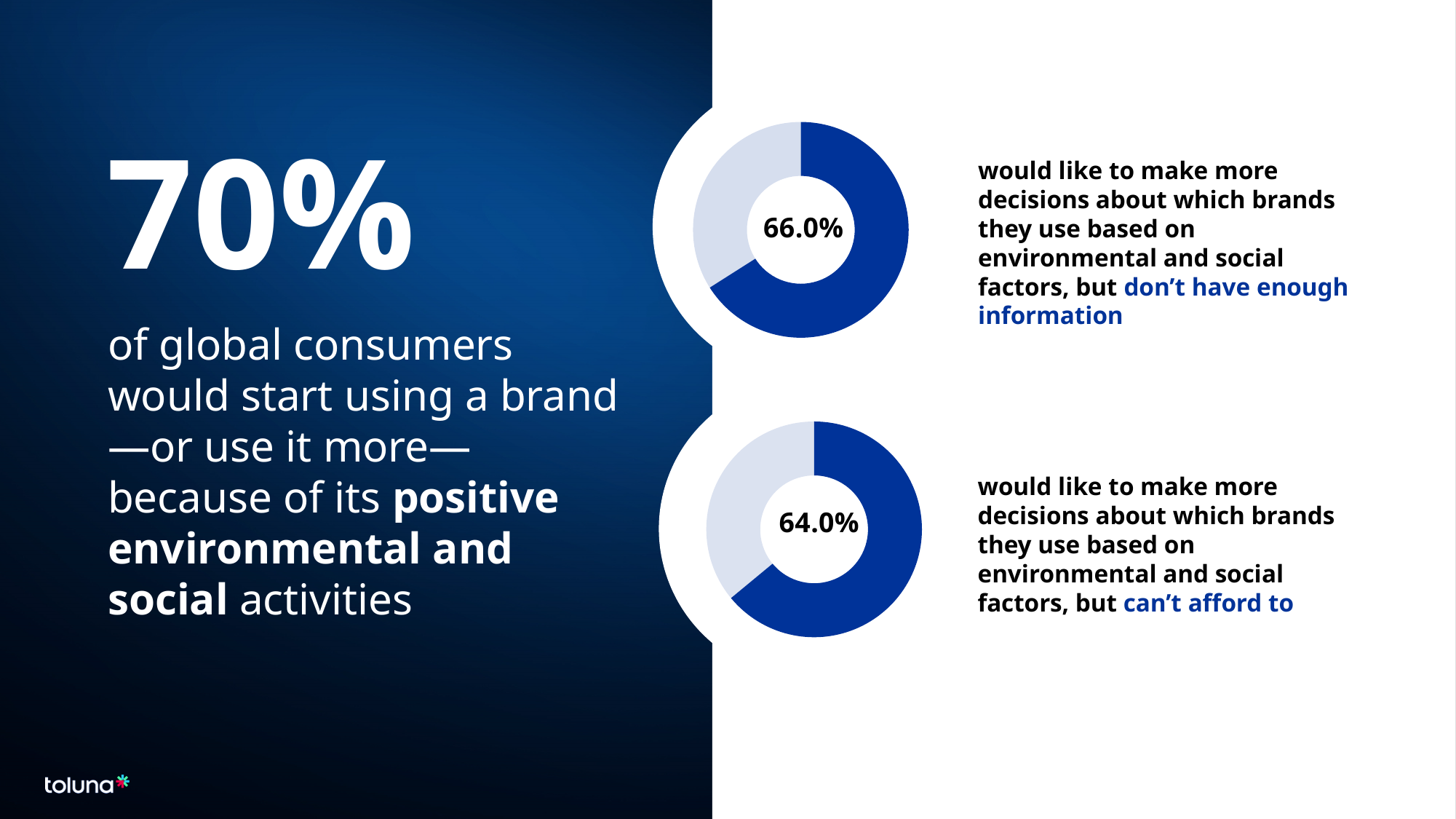
Which donut chart shows the larger value, the top one (don't have enough information) or the bottom one (can't afford to)? The top one (66.0%) In the top donut chart, what share of the ring is left unfilled (light grey) given the 66.0% filled segment? 34.0% In the top donut chart, what percentage would like to make more brand decisions based on environmental and social factors but don't have enough information? 66.0% What colour is used for the filled (highlighted) segment in both donut charts? Dark blue Is the value shown in the top donut chart greater or less than 50%? greater How many donut charts are shown on the slide? 2 Is the value shown in the bottom donut chart greater or less than 75%? less What kind of chart is used on the right side of the slide to show the 66.0% and 64.0% figures? Donut (pie) chart In the bottom donut chart, what percentage would like to make more brand decisions based on environmental and social factors but can't afford to? 64.0% In the bottom donut chart, what share of the ring is left unfilled (light grey) given the 64.0% filled segment? 36.0% What large headline percentage is shown on the left side of the slide next to the donut charts? 70% What is the difference between the value in the top donut chart and the value in the bottom donut chart? 2.0 percentage points